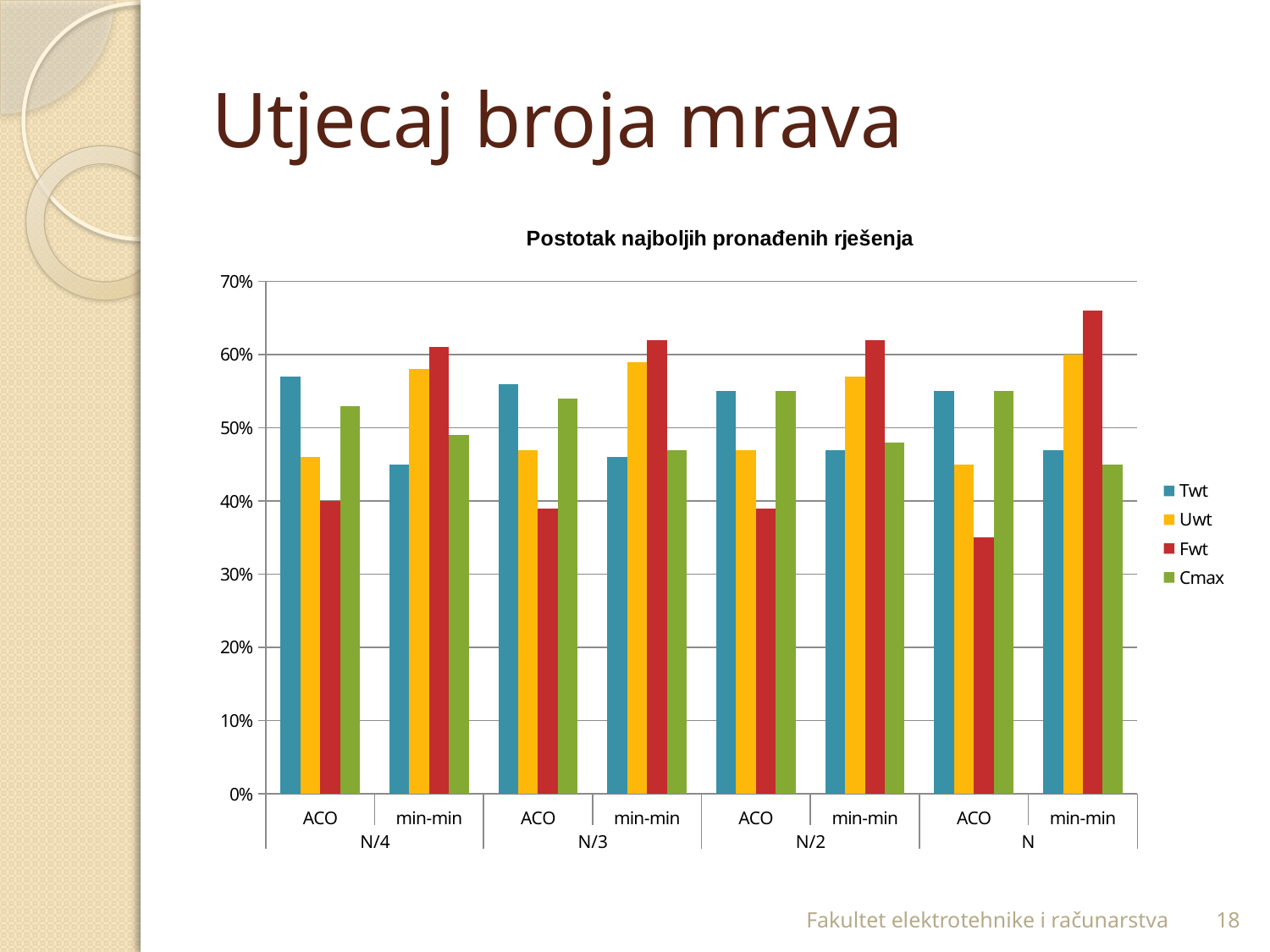
For min-min under N/4, which is larger: Fwt or Twt? Fwt Is the Twt value for ACO under N/4 greater or less than 50%? greater What is the title of the chart? Postotak najboljih pronađenih rješenja Which series are listed in the legend? Twt, Uwt, Fwt, Cmax Is the Fwt value for ACO under N greater or less than 40%? less Is the Fwt value for ACO under N/4 greater or less than 50%? less How many series does the legend list? 4 What kind of chart is shown on the slide? bar chart For ACO under N/4, which is larger: Twt or Uwt? Twt How many category groups (ACO/min-min pairs) are shown along the x axis? 4 Which series has the tallest bar in the whole chart, and in which group? Fwt, min-min under N